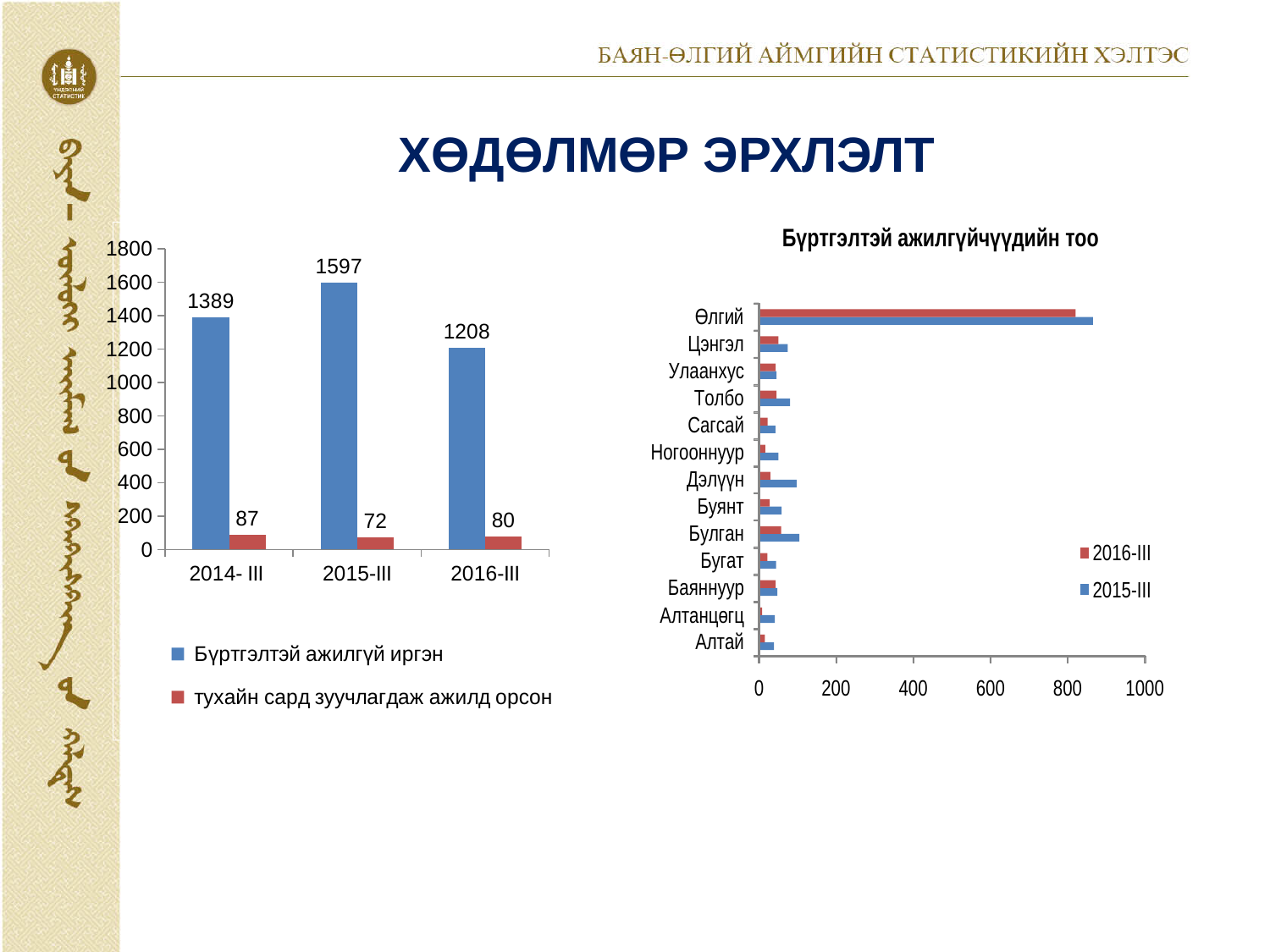
On the left chart, what is the difference between the Бүртгэлтэй ажилгүй иргэн values for 2015-III and 2016-III? 389 On the chart titled Бүртгэлтэй ажилгүйчүүдийн тоо, is the 2015-III value for Өлгий greater or less than 800? greater On the chart titled Бүртгэлтэй ажилгүйчүүдийн тоо, how many categories are shown on the vertical axis? 13 On the chart titled Бүртгэлтэй ажилгүйчүүдийн тоо, which category has the highest value for 2015-III? Өлгий On the left chart, which is larger: the Бүртгэлтэй ажилгүй иргэн value for 2014- III or for 2016-III? 2014- III On the left chart, which period has the lowest value for тухайн сард зуучлагдаж ажилд орсон? 2015-III On the left chart, how many series does the legend list? 2 On the left chart, what is the value of тухайн сард зуучлагдаж ажилд орсон for 2014- III? 87 On the left chart, what is the value of Бүртгэлтэй ажилгүй иргэн for 2015-III? 1597 On the left chart, which period has the highest value for Бүртгэлтэй ажилгүй иргэн? 2015-III What kind of chart is the chart titled Бүртгэлтэй ажилгүйчүүдийн тоо? bar chart On the left chart, does the value of тухайн сард зуучлагдаж ажилд орсон rise or fall from 2015-III to 2016-III? rise